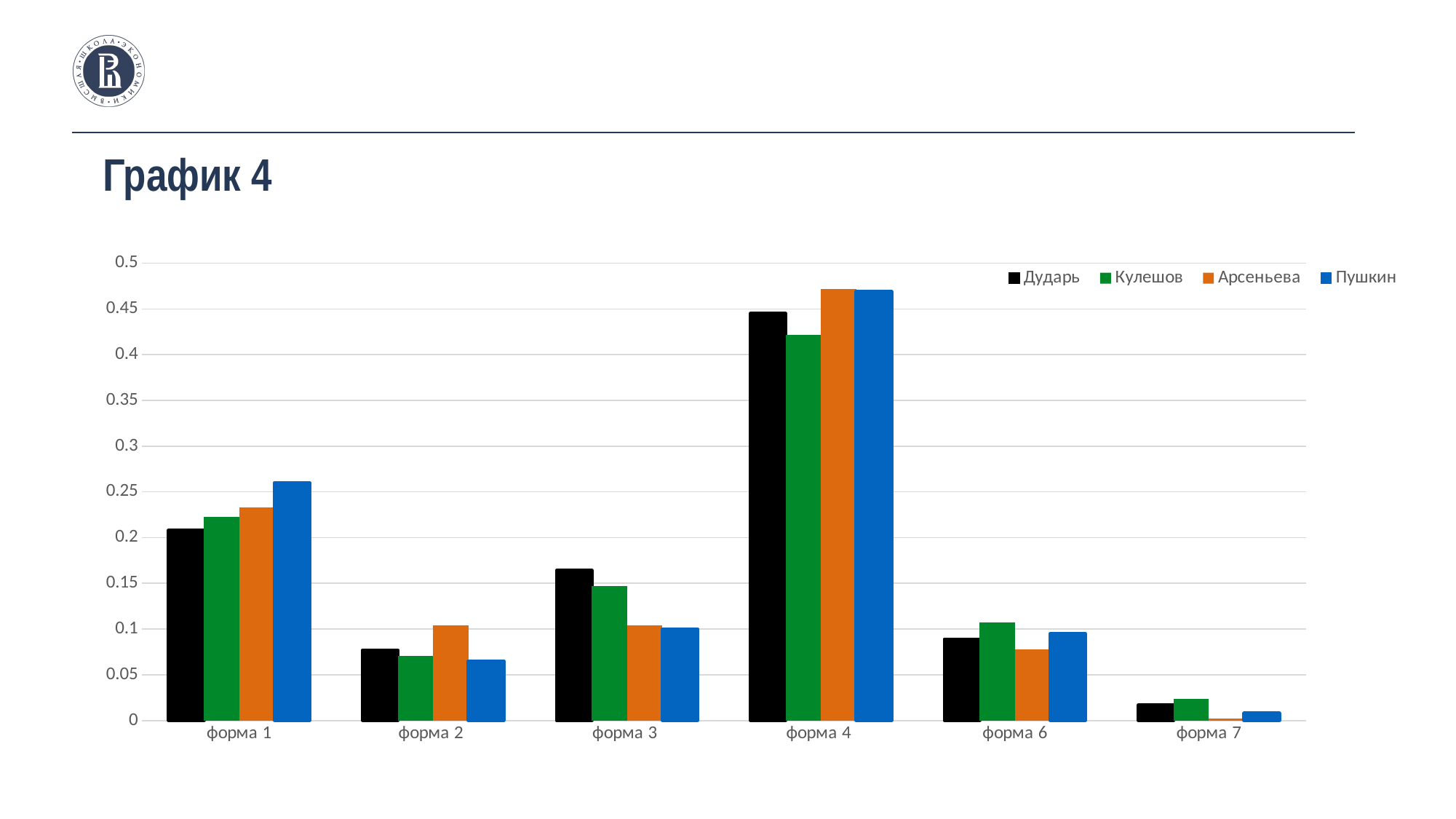
Within форма 1, which series has the highest value? Пушкин Which category has the highest value for the Дударь series? форма 4 In форма 2, which is larger: the value for Арсеньева or the value for Пушкин? Арсеньева What kind of chart is shown on the slide? bar chart How many categories are shown on the x axis of the chart? 6 Is the value for Кулешов in форма 2 greater or less than 0.1? less What is the title of the slide containing the chart? График 4 Is the value for Пушкин in форма 7 greater or less than 0.05? less How many series does the chart's legend list? 4 Which category has the lowest value for the Пушкин series? форма 7 Is the value for Дударь in форма 4 greater or less than 0.4? greater Within форма 3, which series has the highest value? Дударь